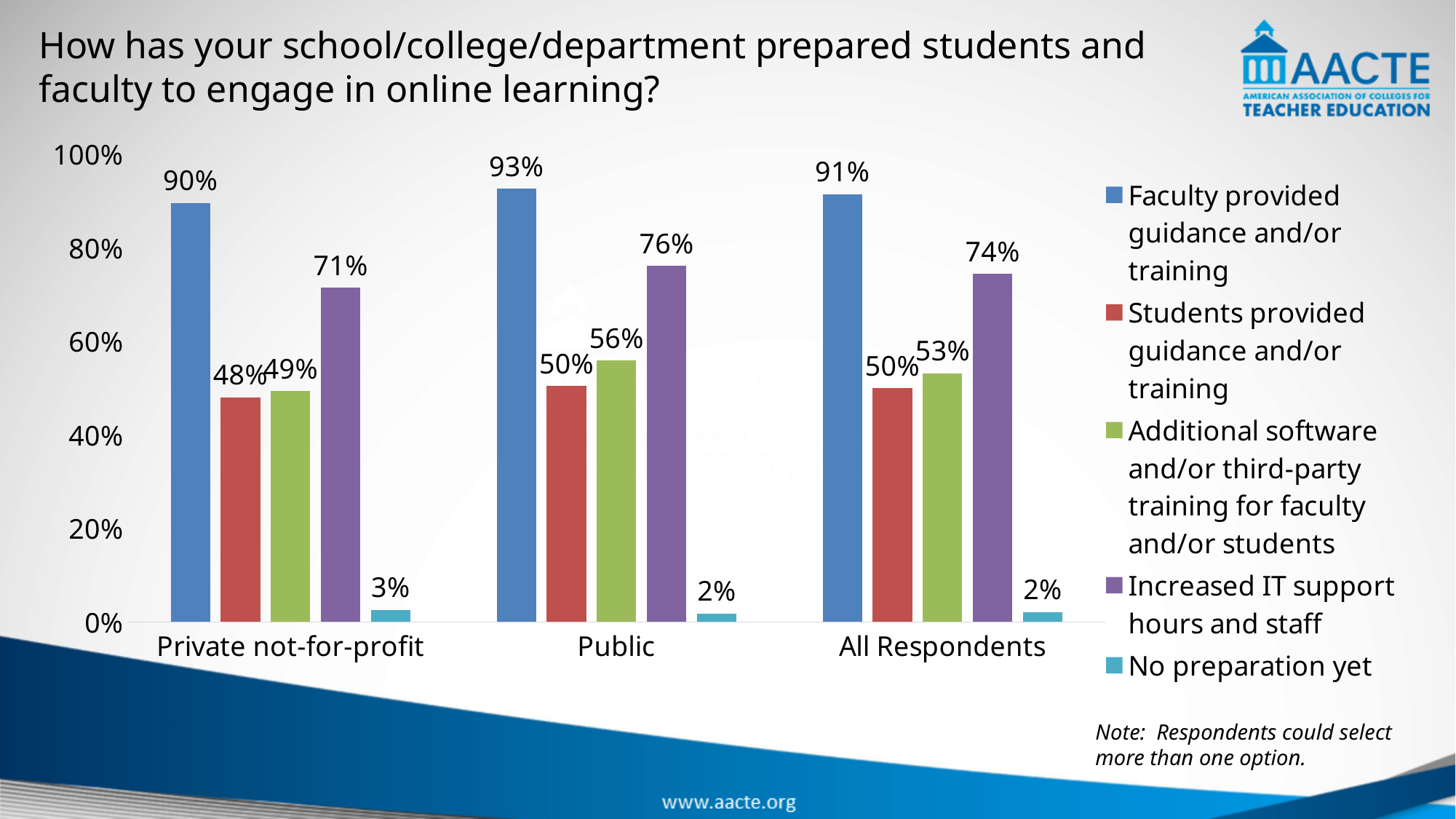
Which is larger for All Respondents: 'Students provided guidance and/or training' or 'Additional software and/or third-party training for faculty and/or students'? Additional software and/or third-party training for faculty and/or students What colour represents 'Increased IT support hours and staff' in the chart? Purple Which category has the highest value for 'Faculty provided guidance and/or training'? Public How many series does the legend list? 5 What percentage of All Respondents reported 'No preparation yet'? 2% What kind of chart is shown on the slide? Bar chart Which series has the lowest value in the Private not-for-profit group? No preparation yet What is the value for 'Increased IT support hours and staff' among Private not-for-profit respondents? 71% What is the difference between the 'Increased IT support hours and staff' values for Public and Private not-for-profit? 5% What percentage of Public respondents reported that faculty were provided guidance and/or training? 93% How many categories are shown on the x axis? 3 What is the value for 'Additional software and/or third-party training for faculty and/or students' in the Public group? 56%